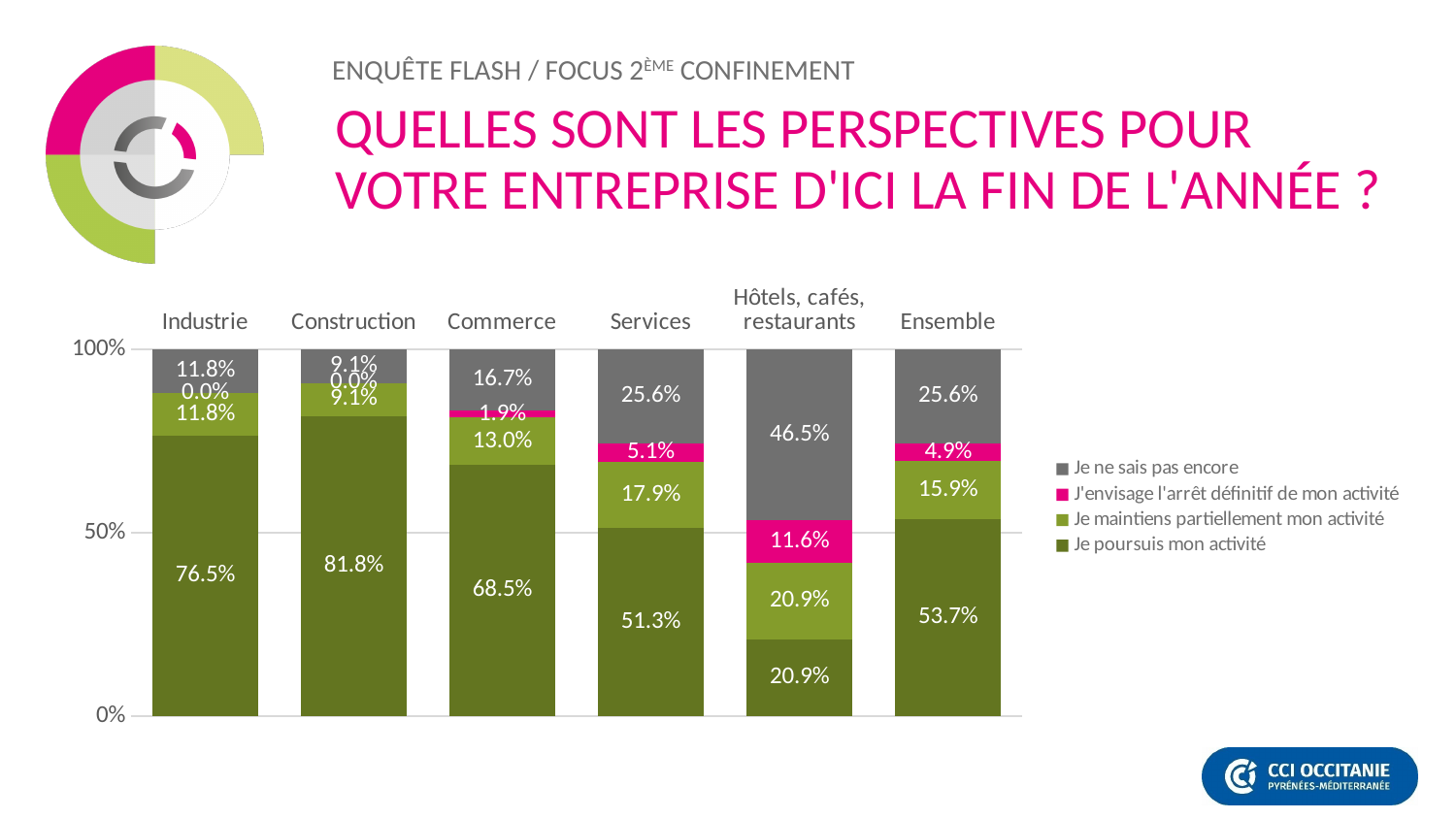
What is the value of "Je poursuis mon activité" for Construction? 81.8% What is the difference between the "Je poursuis mon activité" values for Industrie and Commerce? 8.0% What is the value of "Je ne sais pas encore" for Hôtels, cafés, restaurants? 46.5% Which category has the lowest value for "Je poursuis mon activité"? Hôtels, cafés, restaurants What is the value of "Je maintiens partiellement mon activité" for Services? 17.9% Which series is shown in pink in the legend? J'envisage l'arrêt définitif de mon activité What is the value of "J'envisage l'arrêt définitif de mon activité" for Ensemble? 4.9% What kind of chart is shown on the slide? stacked bar chart How many series does the legend list? 4 Which is larger: the "Je ne sais pas encore" value for Commerce or for Services? Services Which category has the highest value for "Je poursuis mon activité"? Construction How many categories are shown along the x axis? 6